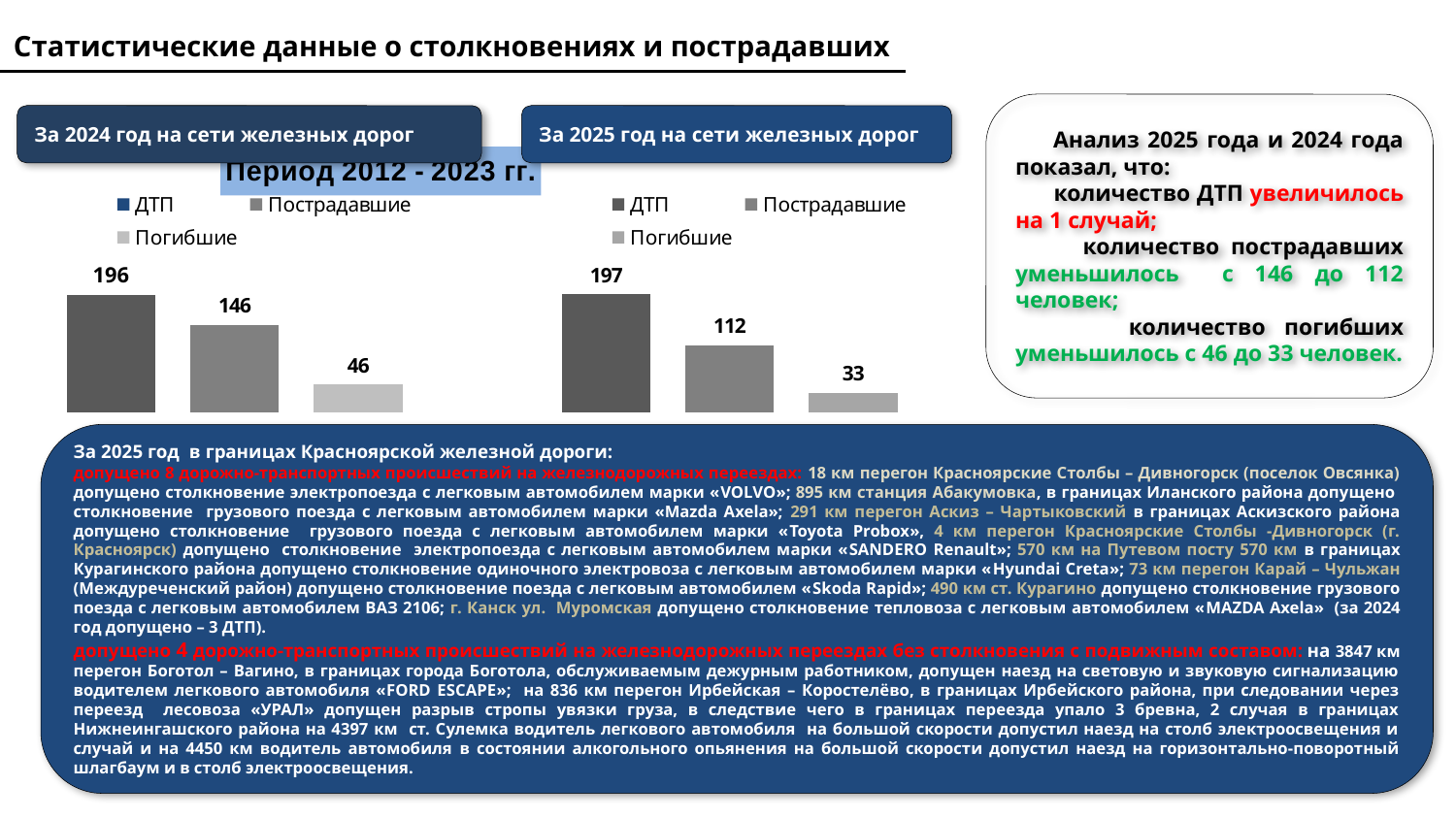
On the chart 'За 2025 год на сети железных дорог', what is the difference between Пострадавшие and Погибшие? 79 How many entries does the legend of the chart 'За 2025 год на сети железных дорог' list? 3 On the chart 'За 2024 год на сети железных дорог', which category has the lowest value? Погибшие On the chart 'За 2024 год на сети железных дорог', what is the value for Погибшие? 46 On the chart 'За 2025 год на сети железных дорог', what is the value for Пострадавшие? 112 On the chart 'За 2025 год на сети железных дорог', what is the value for ДТП? 197 On the chart 'За 2024 год на сети железных дорог', what is the value for Пострадавшие? 146 On the chart 'За 2025 год на сети железных дорог', which category has the highest value? ДТП On the chart 'За 2024 год на сети железных дорог', what is the difference between ДТП and Пострадавшие? 50 What type of chart is 'За 2024 год на сети железных дорог'? Bar chart On the chart 'За 2024 год на сети железных дорог', what is the value for ДТП? 196 On the chart 'За 2025 год на сети железных дорог', what is the value for Погибшие? 33